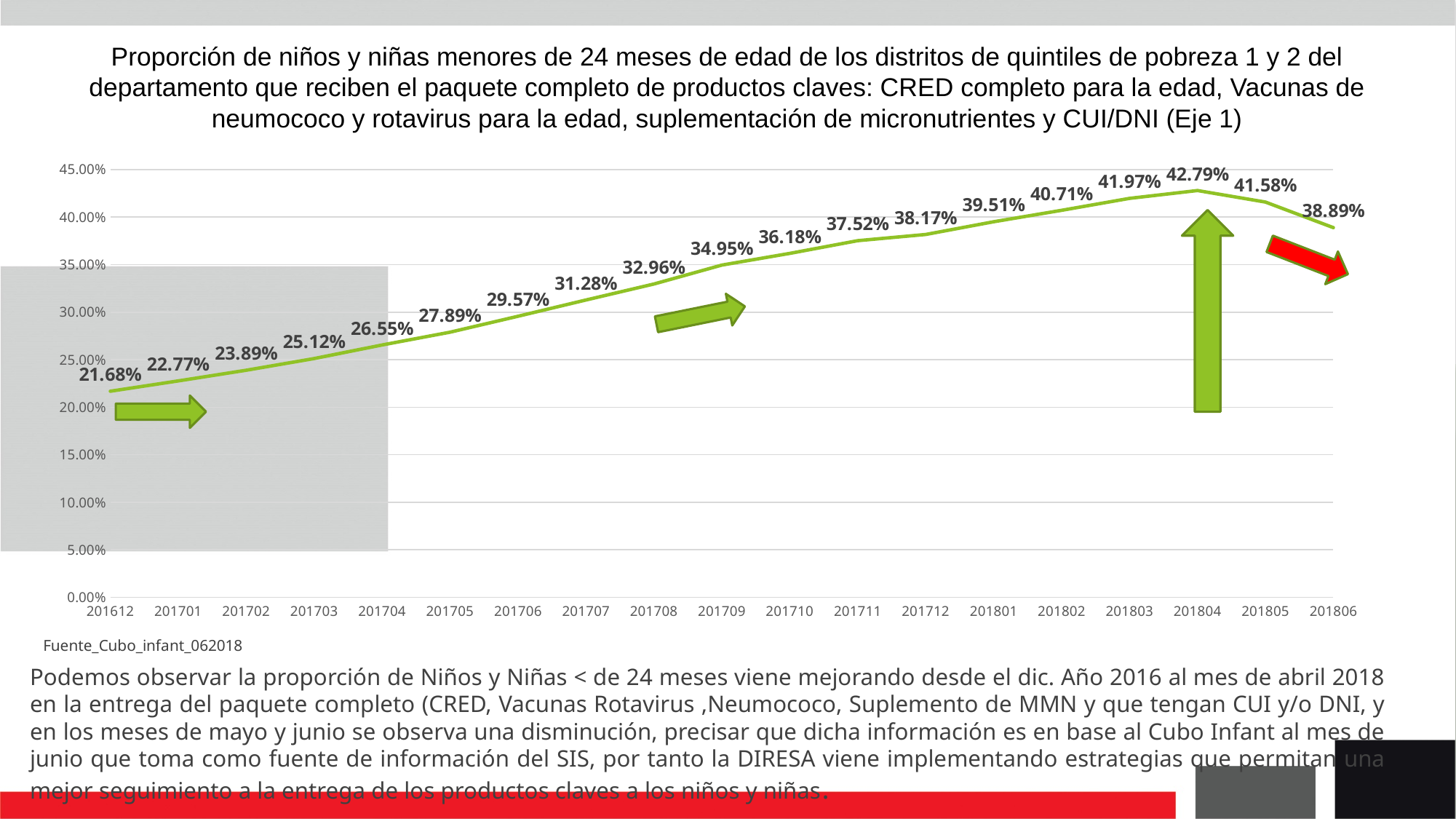
How many data points are plotted on the line? 19 What is the value for 201806? 38.89% What is the difference between the values for 201612 and 201804? 21.11% What is the value for 201612? 21.68% What is the value for 201709? 34.95% Which period has the lowest value? 201612 What type of chart is shown on the slide? line chart Which is larger, the value for 201805 or the value for 201806? 201805 What is the value for 201804? 42.79% Does the line rise or fall from 201612 to 201804? rise What is the difference between the values for 201804 and 201806? 3.90% Which period has the highest value? 201804